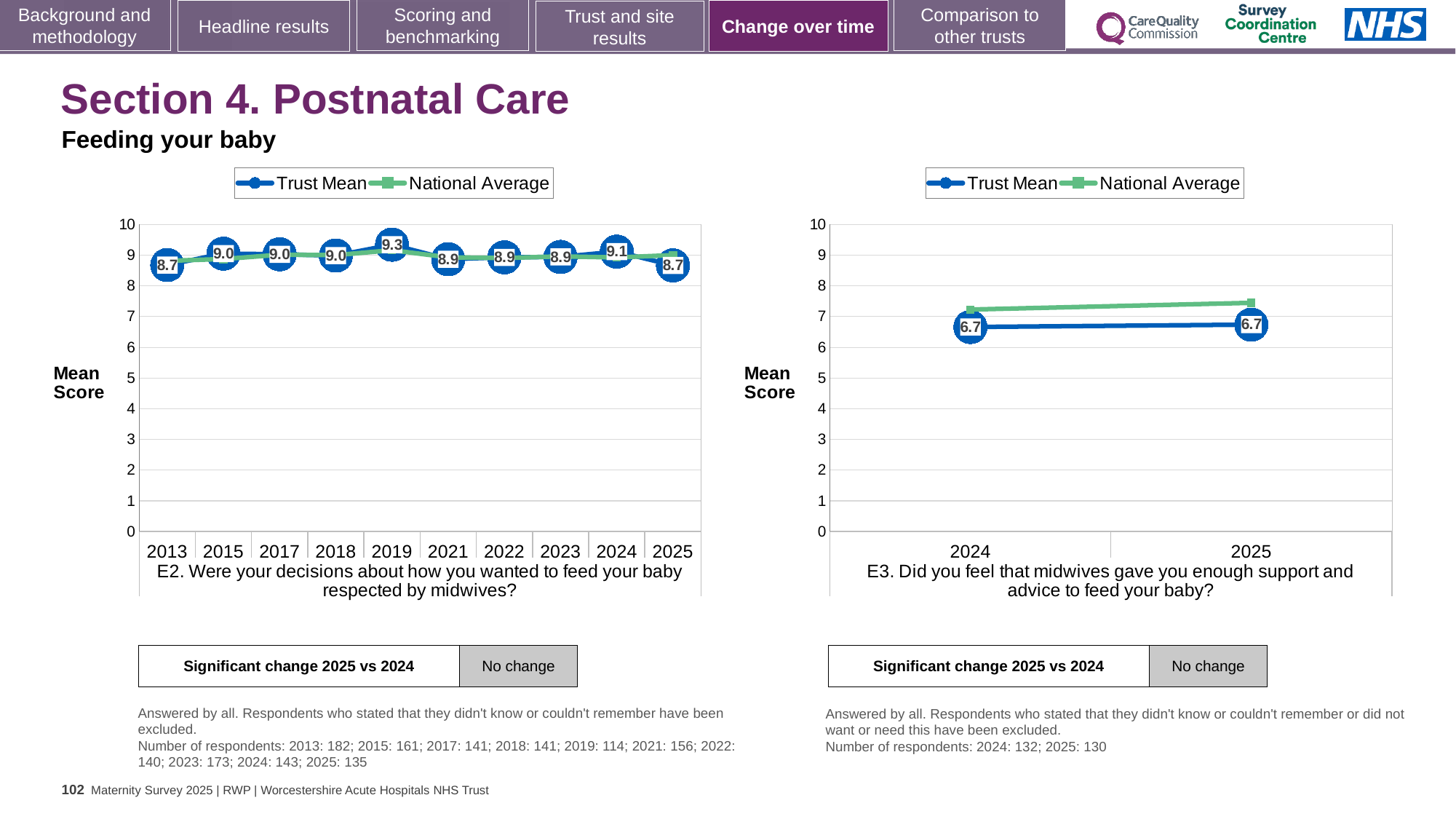
What type of chart is the E2 chart on the left? line chart In the E2 chart on the left, what is the difference between the Trust Mean scores for 2024 and 2025? 0.4 In the E3 chart on the right, what is the Trust Mean score for 2024? 6.7 How many series does the legend of the E3 chart on the right list? 2 In the E2 chart on the left, how many years are shown on the x axis? 10 In the E3 chart on the right, is the National Average for 2025 greater or less than 7? greater In the E2 chart on the left, is the Trust Mean score for 2013 higher or lower than for 2015? lower In the E2 chart on the left, which year has the highest Trust Mean score? 2019 In the E2 chart on the left, what is the Trust Mean score for 2025? 8.7 In the E3 chart on the right, which series is higher in 2025, Trust Mean or National Average? National Average In the E3 chart on the right, does the Trust Mean score rise, fall or stay the same from 2024 to 2025? stays the same In the E2 chart on the left, what is the Trust Mean score for 2019? 9.3